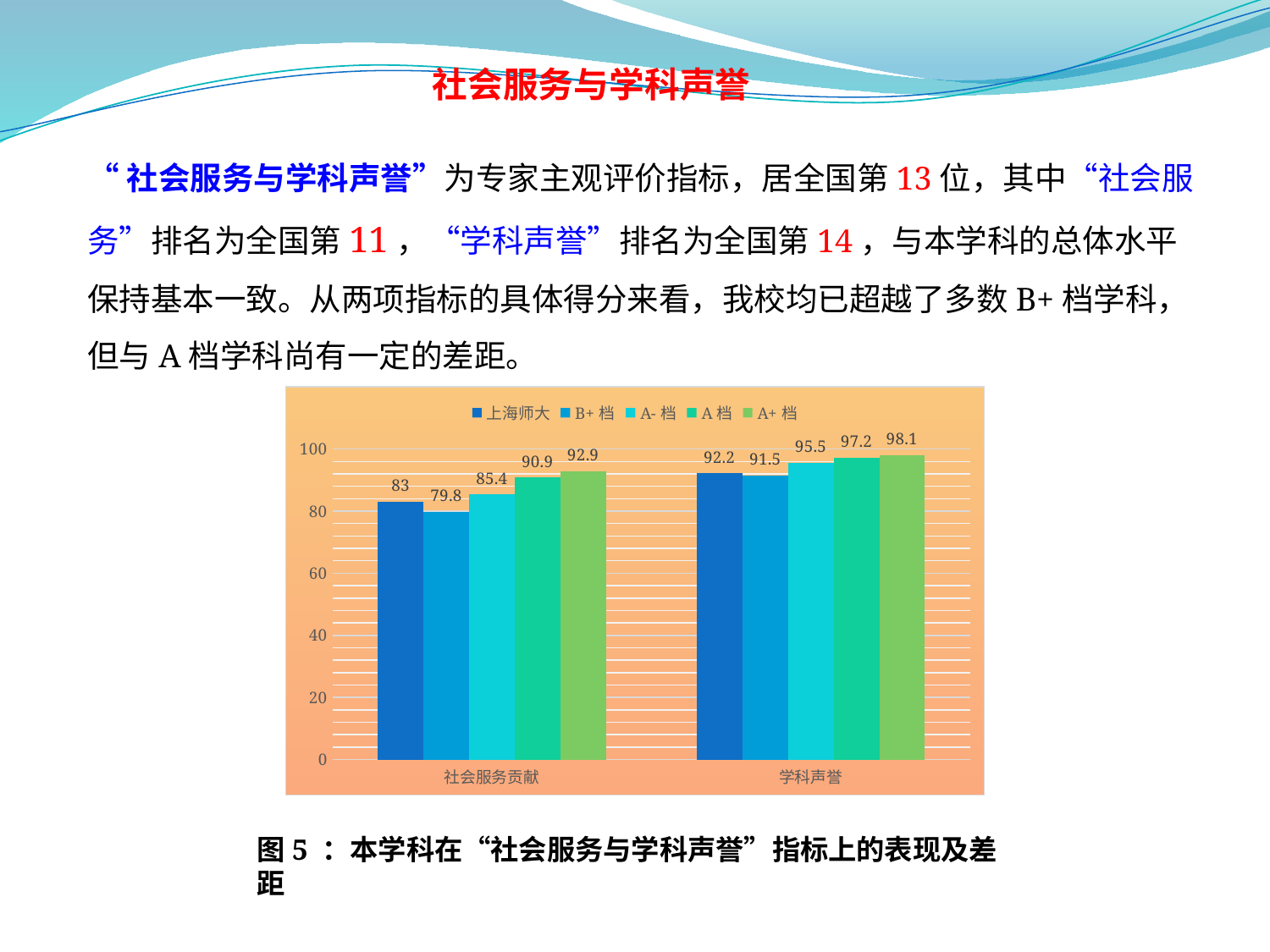
Is the value for A- 档 in the 社会服务贡献 category greater or less than 80? greater Which series has the highest value in the 学科声誉 category? A+ 档 How many categories are shown on the x axis of the chart? 2 Which series has the lowest value in the 社会服务贡献 category? B+ 档 What is the first series listed in the chart legend? 上海师大 What is the value for B+ 档 in the 社会服务贡献 category? 79.8 What is the value for A+ 档 in the 学科声誉 category? 98.1 What kind of chart is shown on the slide? bar chart What is the value for 上海师大 in the 社会服务贡献 category? 83 What is the difference between the A+ 档 value and the 上海师大 value in the 社会服务贡献 category? 9.9 In the 学科声誉 category, which is larger: the value for 上海师大 or the value for B+ 档? 上海师大 How many series does the chart legend list? 5